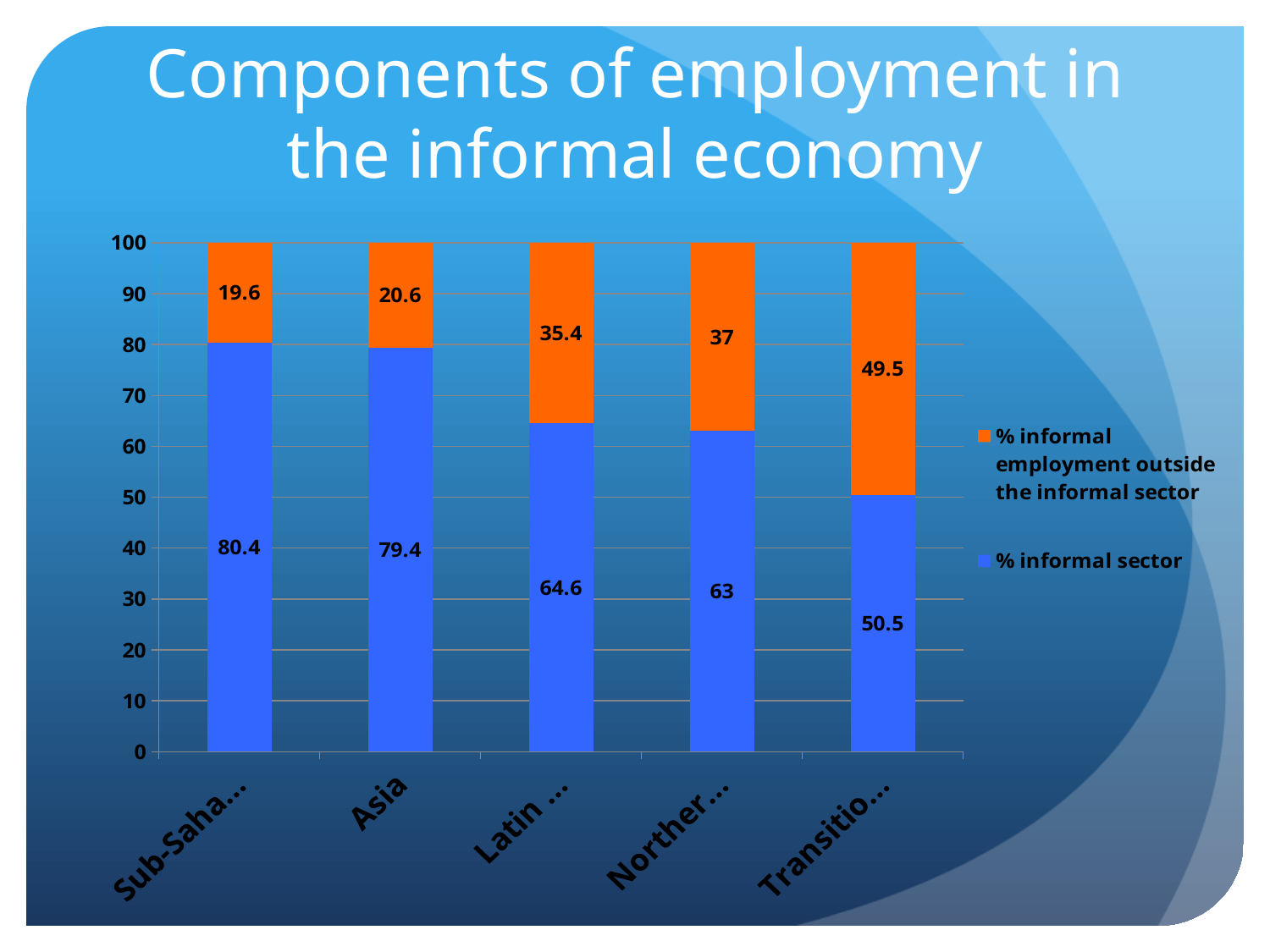
Does the % informal sector value rise or fall moving from left to right along the x axis? Fall What type of chart is shown on the slide? Stacked bar chart Which category has the highest % informal sector value? The first bar from the left (80.4) What is the value of % informal sector for the first bar from the left? 80.4 Which category has the lowest % informal sector value? The rightmost bar (50.5) How many series does the legend list? 2 What is the title of the chart? Components of employment in the informal economy What is the value of % informal sector for Asia? 79.4 How many categories (bars) are plotted on the x axis? 5 What is the value of % informal employment outside the informal sector for the rightmost bar? 49.5 What is the value of % informal employment outside the informal sector for Asia? 20.6 What is the difference between the % informal sector values for Asia and the rightmost bar? 28.9